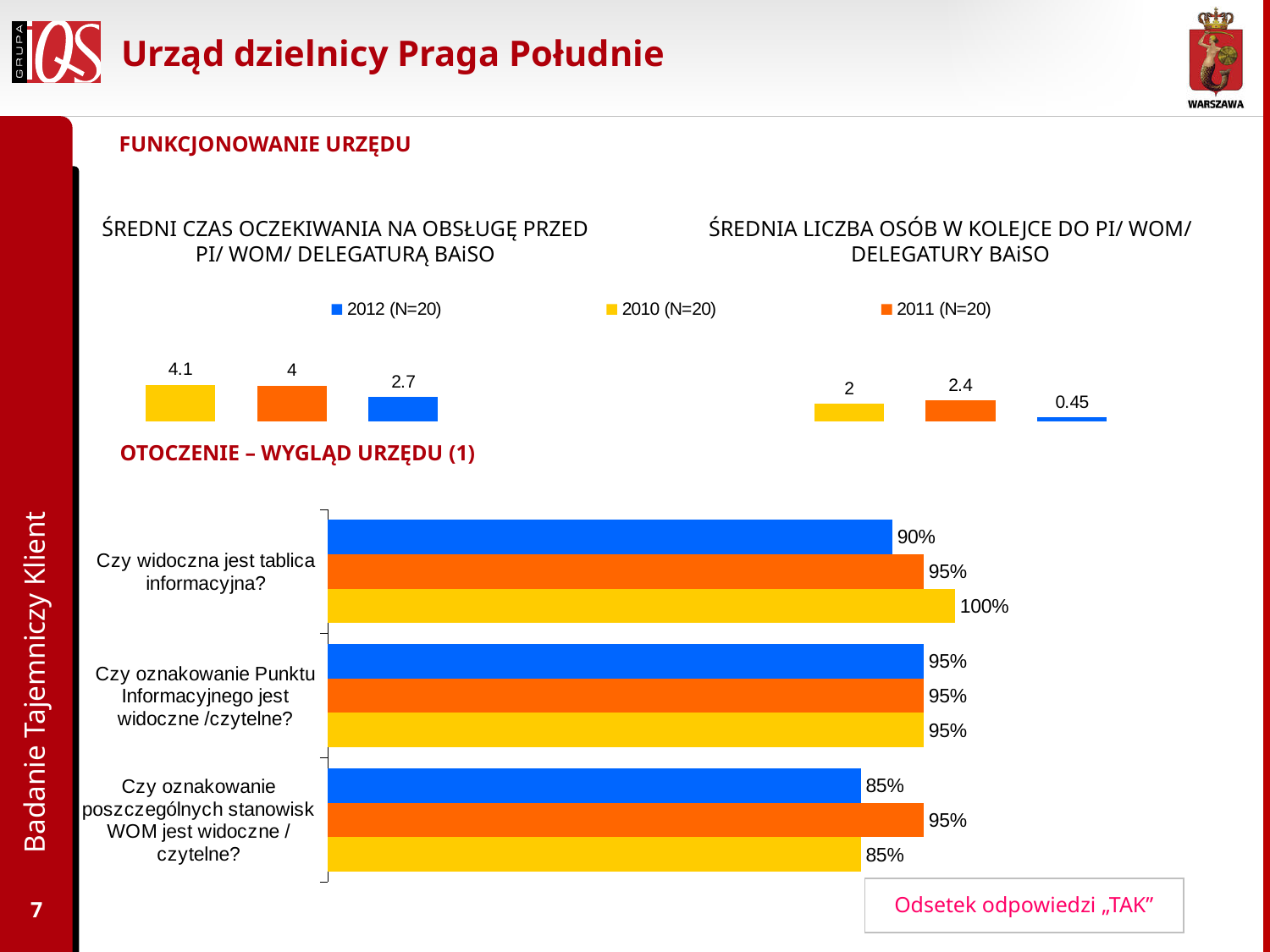
In the chart 'ŚREDNIA LICZBA OSÓB W KOLEJCE DO PI/ WOM/ DELEGATURY BAiSO', which is larger: the value for 2010 or the value for 2011? 2011 In the chart 'ŚREDNI CZAS OCZEKIWANIA NA OBSŁUGĘ PRZED PI/ WOM/ DELEGATURĄ BAiSO', which year has the highest value? 2010 (N=20) In the chart 'ŚREDNI CZAS OCZEKIWANIA NA OBSŁUGĘ PRZED PI/ WOM/ DELEGATURĄ BAiSO', what is the value for 2012 (N=20)? 2.7 In the chart 'ŚREDNIA LICZBA OSÓB W KOLEJCE DO PI/ WOM/ DELEGATURY BAiSO', what is the value for 2012 (N=20)? 0.45 In the bottom chart under 'OTOCZENIE – WYGLĄD URZĘDU (1)', what is the blue bar value for 'Czy oznakowanie poszczególnych stanowisk WOM jest widoczne / czytelne?'? 85% In the chart 'ŚREDNIA LICZBA OSÓB W KOLEJCE DO PI/ WOM/ DELEGATURY BAiSO', which year has the lowest value? 2012 (N=20) In the chart 'ŚREDNI CZAS OCZEKIWANIA NA OBSŁUGĘ PRZED PI/ WOM/ DELEGATURĄ BAiSO', what is the difference between the 2010 value and the 2012 value? 1.4 How many series does the legend above the top charts list? 3 How many question categories are shown in the bottom chart under 'OTOCZENIE – WYGLĄD URZĘDU (1)'? 3 In the bottom chart under 'OTOCZENIE – WYGLĄD URZĘDU (1)', what is the difference between the yellow bar and the blue bar for 'Czy widoczna jest tablica informacyjna?'? 10% What type of chart is shown under 'OTOCZENIE – WYGLĄD URZĘDU (1)'? Bar chart In the bottom chart under 'OTOCZENIE – WYGLĄD URZĘDU (1)', what is the yellow bar value for 'Czy widoczna jest tablica informacyjna?'? 100%